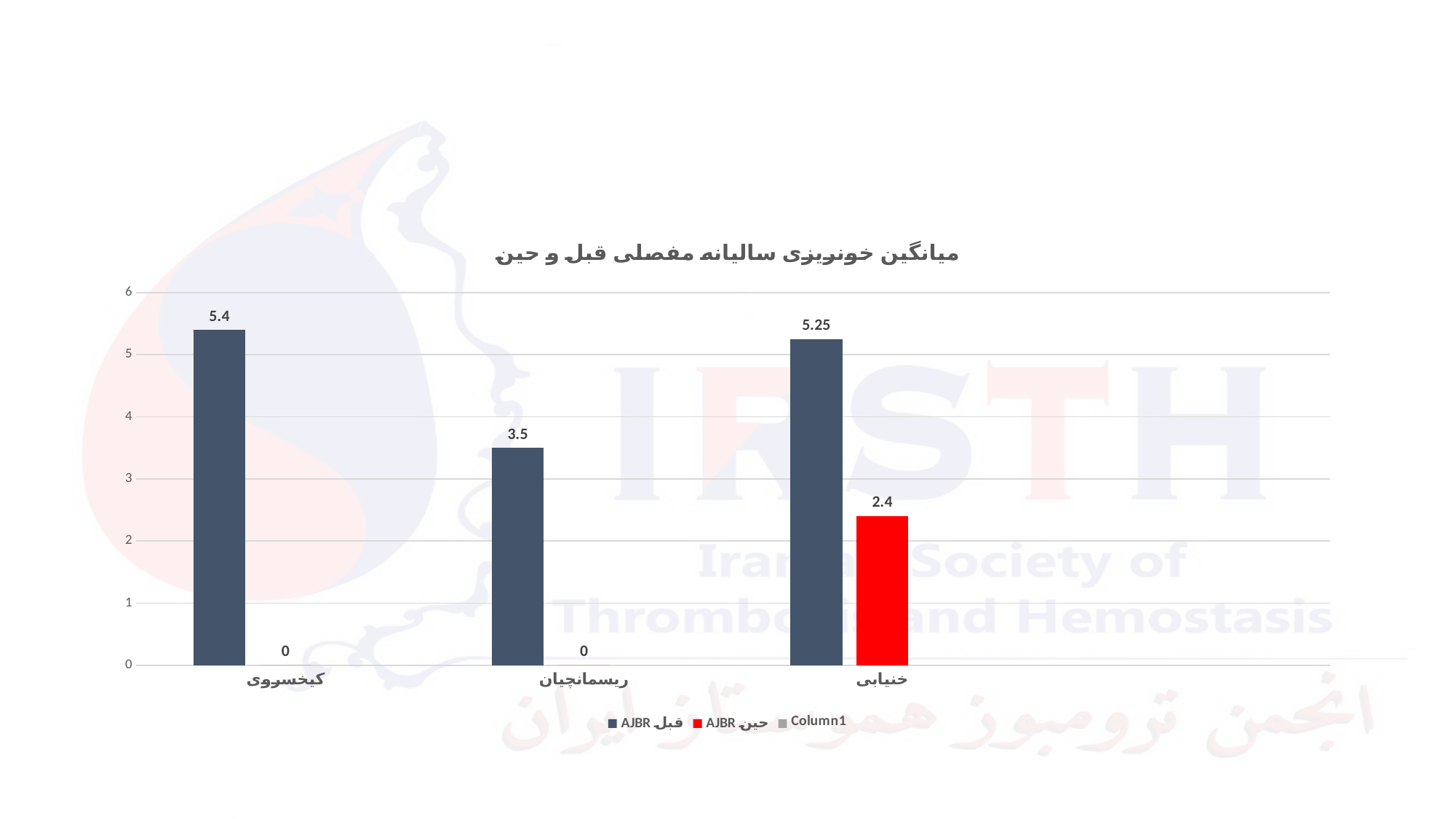
What colour are the AJBR حین bars? Red What is the value of AJBR حین for کیخسروی? 0 What is the value of AJBR قبل for کیخسروی? 5.4 How many categories are shown on the x axis? 3 What is the value of AJBR حین for خنیابی? 2.4 How many series does the legend list? 3 What is the value of AJBR قبل for ریسمانچیان? 3.5 What kind of chart is shown on the slide? Bar chart Which is larger, the AJBR قبل value for کیخسروی or for خنیابی? کیخسروی Which category has the highest AJBR قبل value? کیخسروی Which category has the lowest AJBR قبل value? ریسمانچیان What is the difference between AJBR قبل and AJBR حین for خنیابی? 2.85